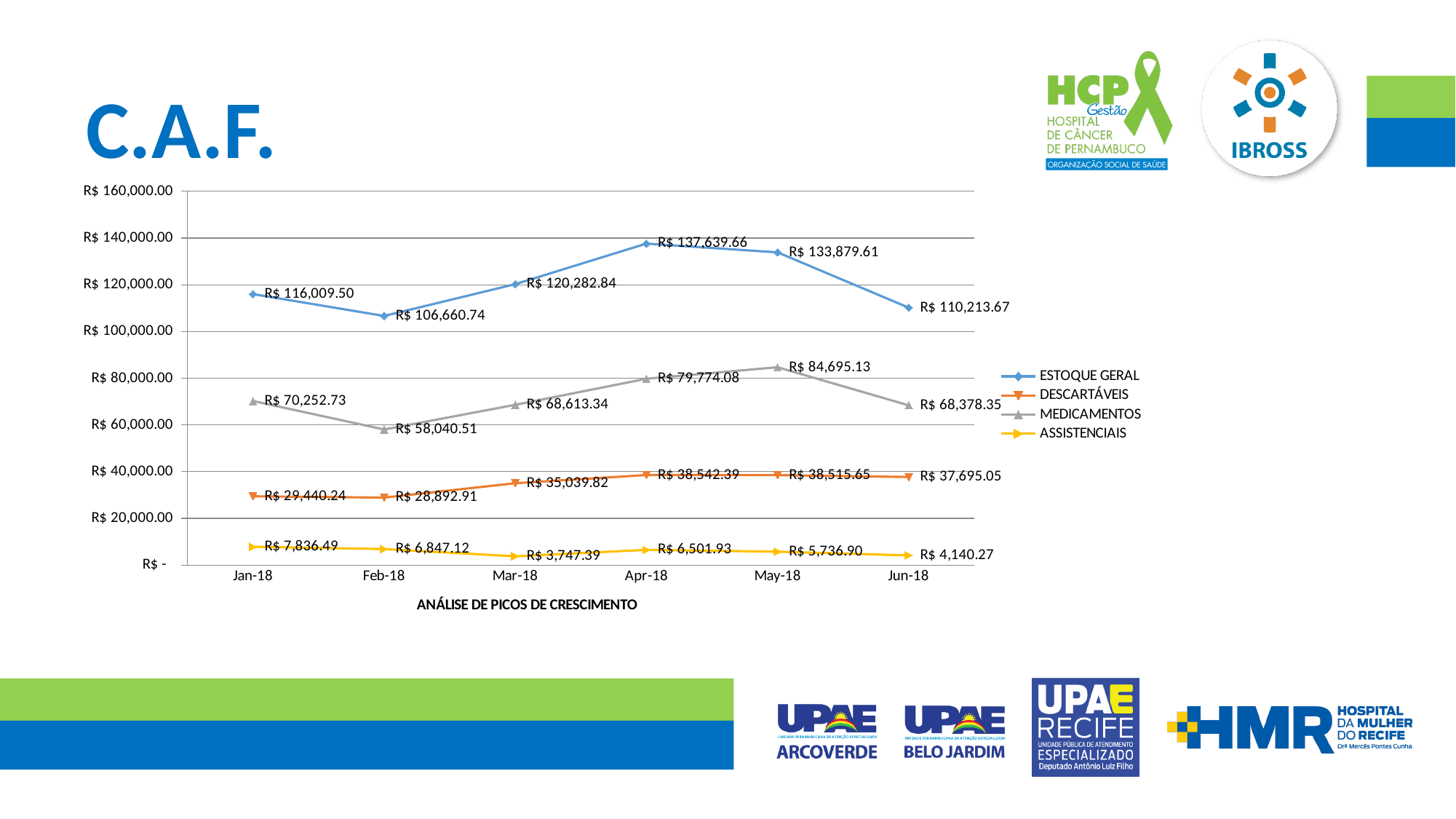
In which month is ASSISTENCIAIS lowest? Mar-18 Does ESTOQUE GERAL rise or fall from Apr-18 to Jun-18? Fall What kind of chart is shown on the slide? Line chart How many series does the legend list? 4 What is the value of DESCARTÁVEIS in Jun-18? R$ 37,695.05 What is the difference between ESTOQUE GERAL in Apr-18 and May-18? R$ 3,760.05 Which is larger for MEDICAMENTOS: Jan-18 or Mar-18? Jan-18 How many months are plotted on the x axis? 6 What is the value of MEDICAMENTOS in Feb-18? R$ 58,040.51 In which month is ESTOQUE GERAL highest? Apr-18 What is the value of ESTOQUE GERAL in Apr-18? R$ 137,639.66 What is the value of ASSISTENCIAIS in Mar-18? R$ 3,747.39